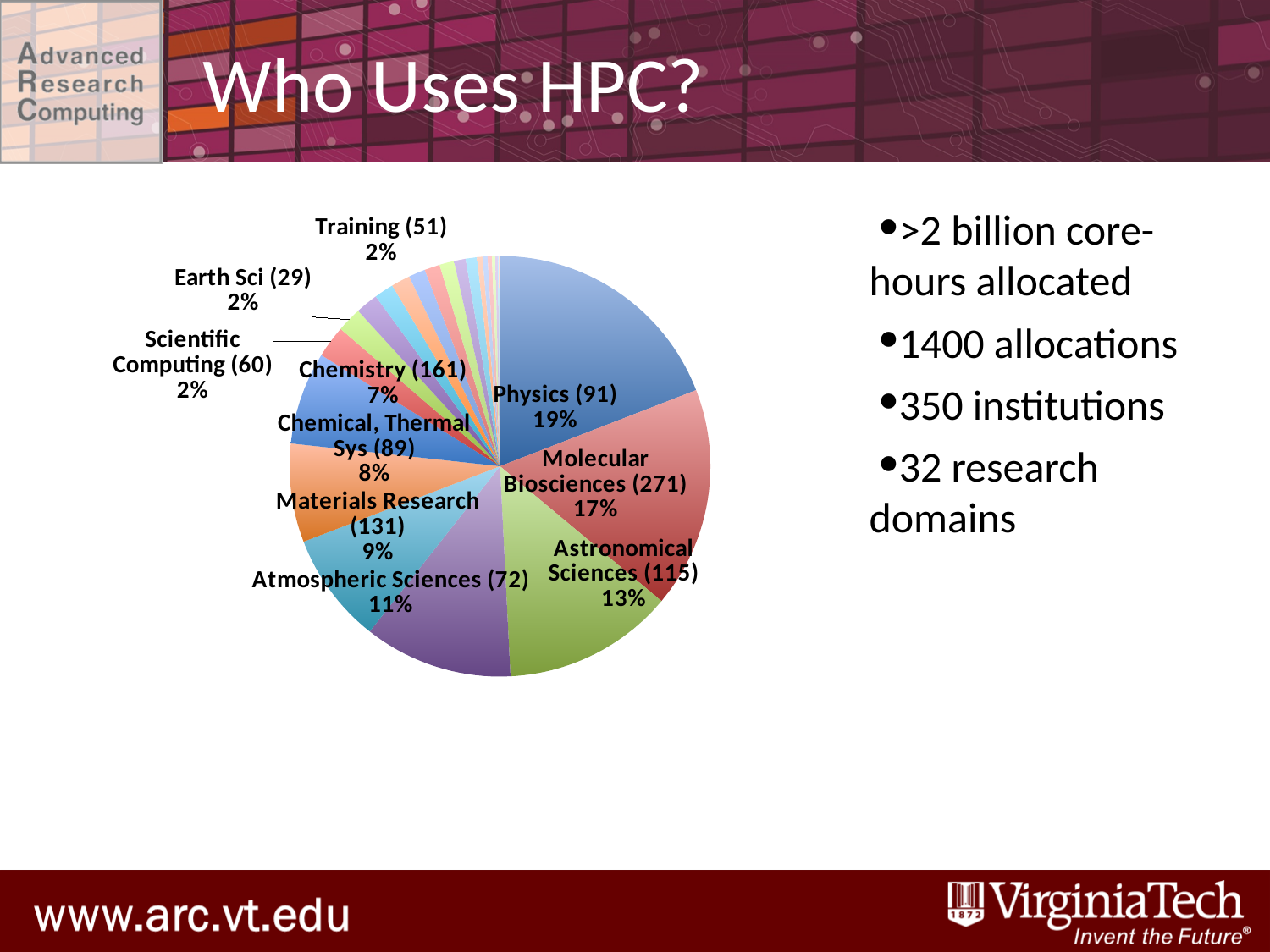
What percentage is shown for Training? 2% What share of the pie does Molecular Biosciences represent? 17% Which has a larger share, Materials Research or Chemistry? Materials Research What is the difference in percentage points between Physics and Astronomical Sciences? 6 What percentage is shown for Chemical, Thermal Sys? 8% What number appears in parentheses next to the Earth Sci label? 29 What type of chart is shown on the slide? pie chart What share of the pie does Physics represent? 19% What percentage is shown for Atmospheric Sciences? 11% What percentage is shown for Astronomical Sciences? 13% Which labeled slice has the largest share of the pie? Physics What number appears in parentheses next to the Chemistry label? 161